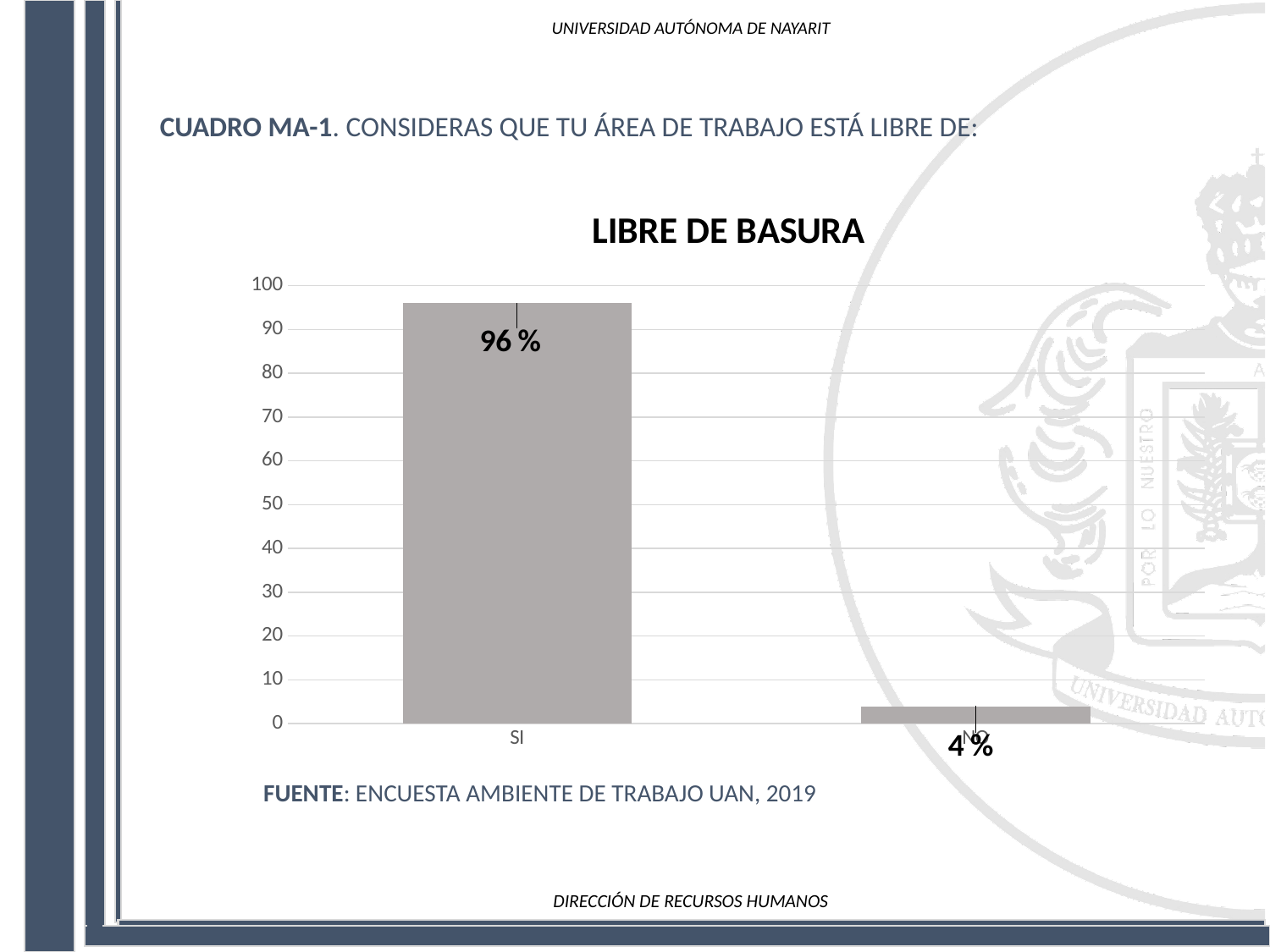
Which category has the lowest value? NO Which category has the highest value? SI What is the difference between the values for SI and NO? 92 % What is the maximum value shown on the y axis? 100 What kind of chart is shown? bar chart What is the value for SI? 96 % Is the value for SI greater or less than 90? greater What is the title of the chart? LIBRE DE BASURA How many categories are shown on the x axis? 2 Which is larger, the value for SI or the value for NO? SI Is the value for NO greater or less than 10? less What is the value for NO? 4 %